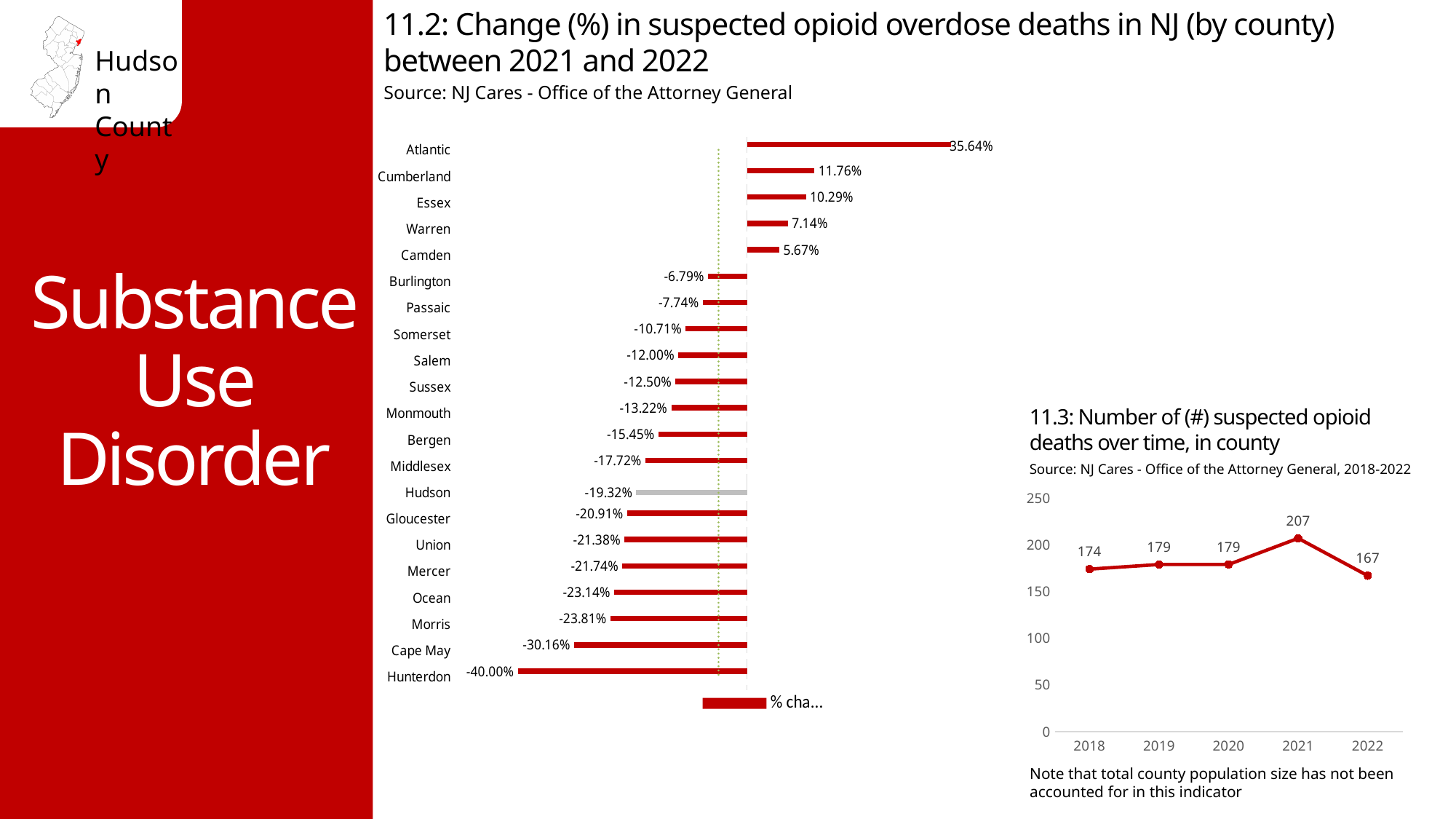
In the chart '11.2: Change (%) in suspected opioid overdose deaths in NJ (by county) between 2021 and 2022', how many counties are shown? 21 What kind of chart is '11.3: Number of (#) suspected opioid deaths over time, in county'? Line chart In the chart '11.3: Number of (#) suspected opioid deaths over time, in county', what is the value for 2021? 207 In the chart '11.2: Change (%) in suspected opioid overdose deaths in NJ (by county) between 2021 and 2022', which county has the highest value? Atlantic In the chart '11.2: Change (%) in suspected opioid overdose deaths in NJ (by county) between 2021 and 2022', what is the value for Hudson? -19.32% What kind of chart is '11.2: Change (%) in suspected opioid overdose deaths in NJ (by county) between 2021 and 2022'? Bar chart In the chart '11.3: Number of (#) suspected opioid deaths over time, in county', which year has the lowest value? 2022 In the chart '11.3: Number of (#) suspected opioid deaths over time, in county', what is the difference between the values for 2021 and 2022? 40 In the chart '11.2: Change (%) in suspected opioid overdose deaths in NJ (by county) between 2021 and 2022', what is the difference between the values for Atlantic and Cumberland? 23.88% In the chart '11.2: Change (%) in suspected opioid overdose deaths in NJ (by county) between 2021 and 2022', which is larger, the value for Essex or the value for Warren? Essex In the chart '11.2: Change (%) in suspected opioid overdose deaths in NJ (by county) between 2021 and 2022', what is the value for Cumberland? 11.76% In the chart '11.2: Change (%) in suspected opioid overdose deaths in NJ (by county) between 2021 and 2022', which county has the lowest value? Hunterdon